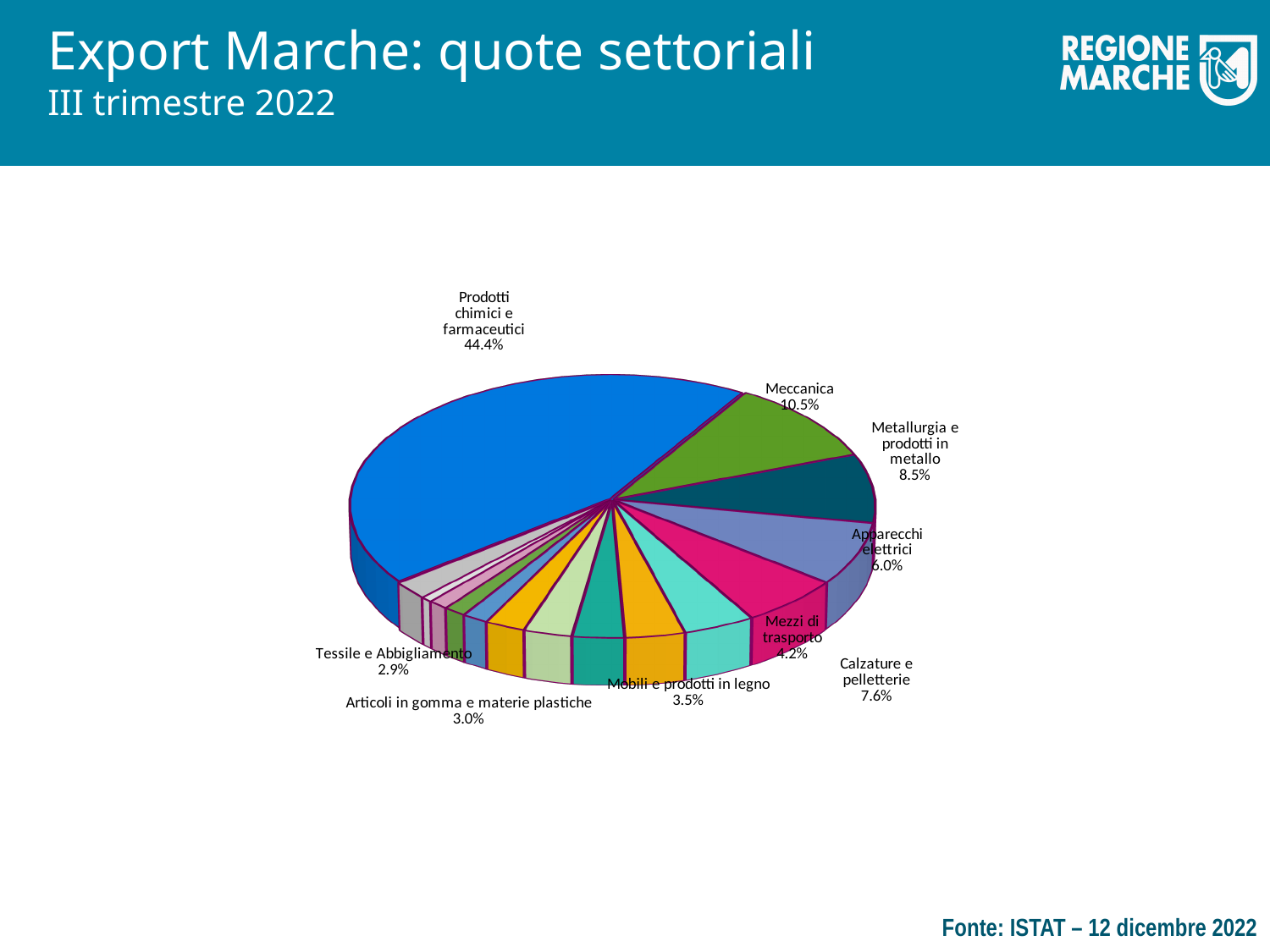
What share of the pie does Prodotti chimici e farmaceutici hold? 44.4% Which is larger, the share for Meccanica or the share for Metallurgia e prodotti in metallo? Meccanica What is the title of the slide containing the chart? Export Marche: quote settoriali III trimestre 2022 What value is shown for Apparecchi elettrici? 6.0% What is the share for Calzature e pelletterie? 7.6% Which sector has the largest slice of the pie? Prodotti chimici e farmaceutici What is the difference between the shares of Calzature e pelletterie and Mezzi di trasporto? 3.4% What is the share for Tessile e Abbigliamento? 2.9% What type of chart is shown on the slide? Pie chart What is the value shown for Meccanica? 10.5% What percentage is labelled for Metallurgia e prodotti in metallo? 8.5% What is the difference between the shares of Mobili e prodotti in legno and Articoli in gomma e materie plastiche? 0.5%